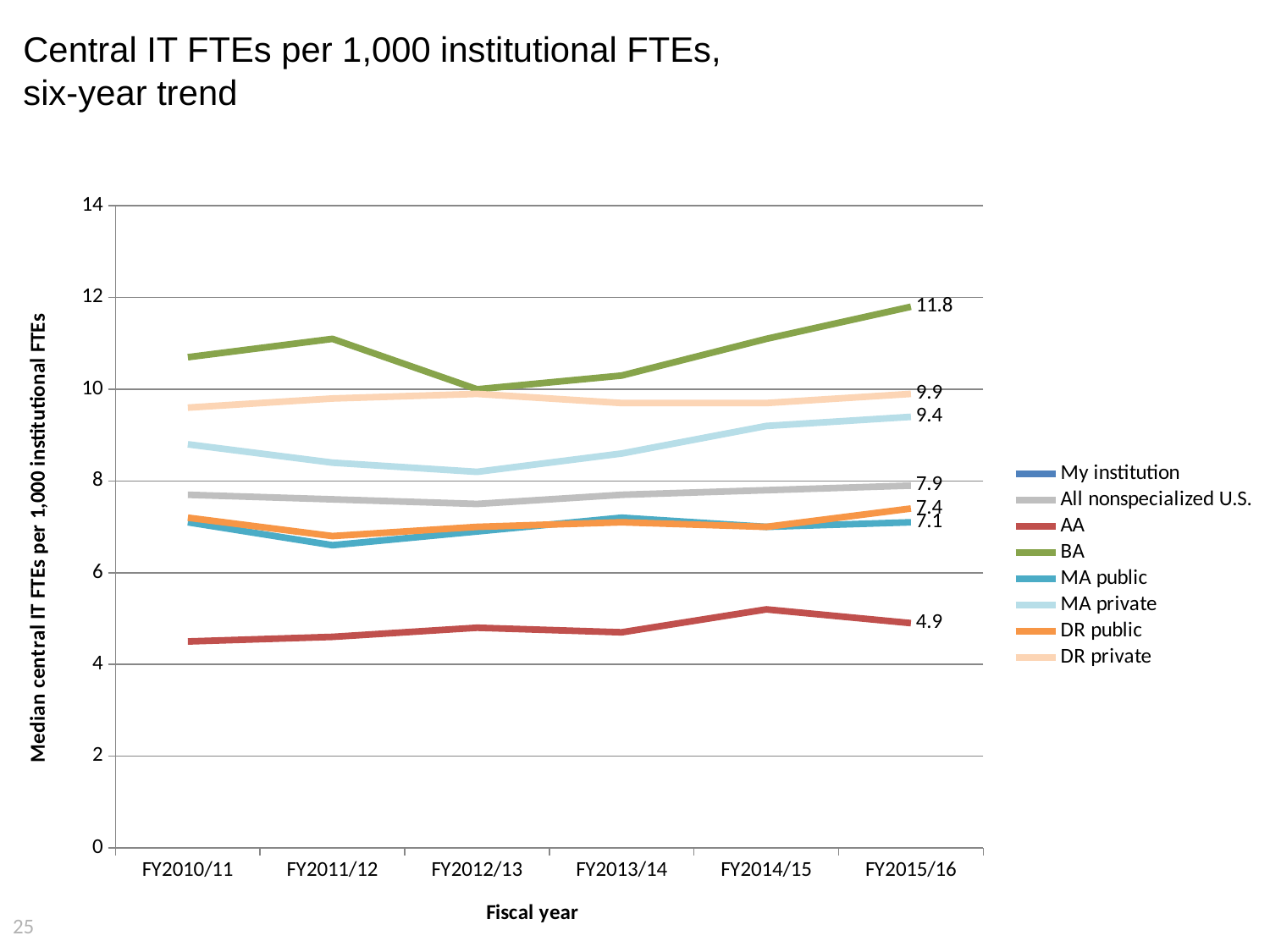
What is the value for All nonspecialized U.S. in FY2015/16? 7.9 Which series has the highest value in FY2015/16? BA What kind of chart is shown on the slide? line chart What is the difference between the BA and AA values in FY2015/16? 6.9 How many series does the legend list? 8 How many fiscal years are shown on the x axis? 6 What is the value for AA in FY2015/16? 4.9 Which series has the lowest value in FY2015/16? AA What is the value for BA in FY2015/16? 11.8 Is the value for BA in FY2010/11 greater or less than 10? greater Does the AA line generally rise or fall from FY2010/11 to FY2015/16? rise What is the value for MA private in FY2015/16? 9.4